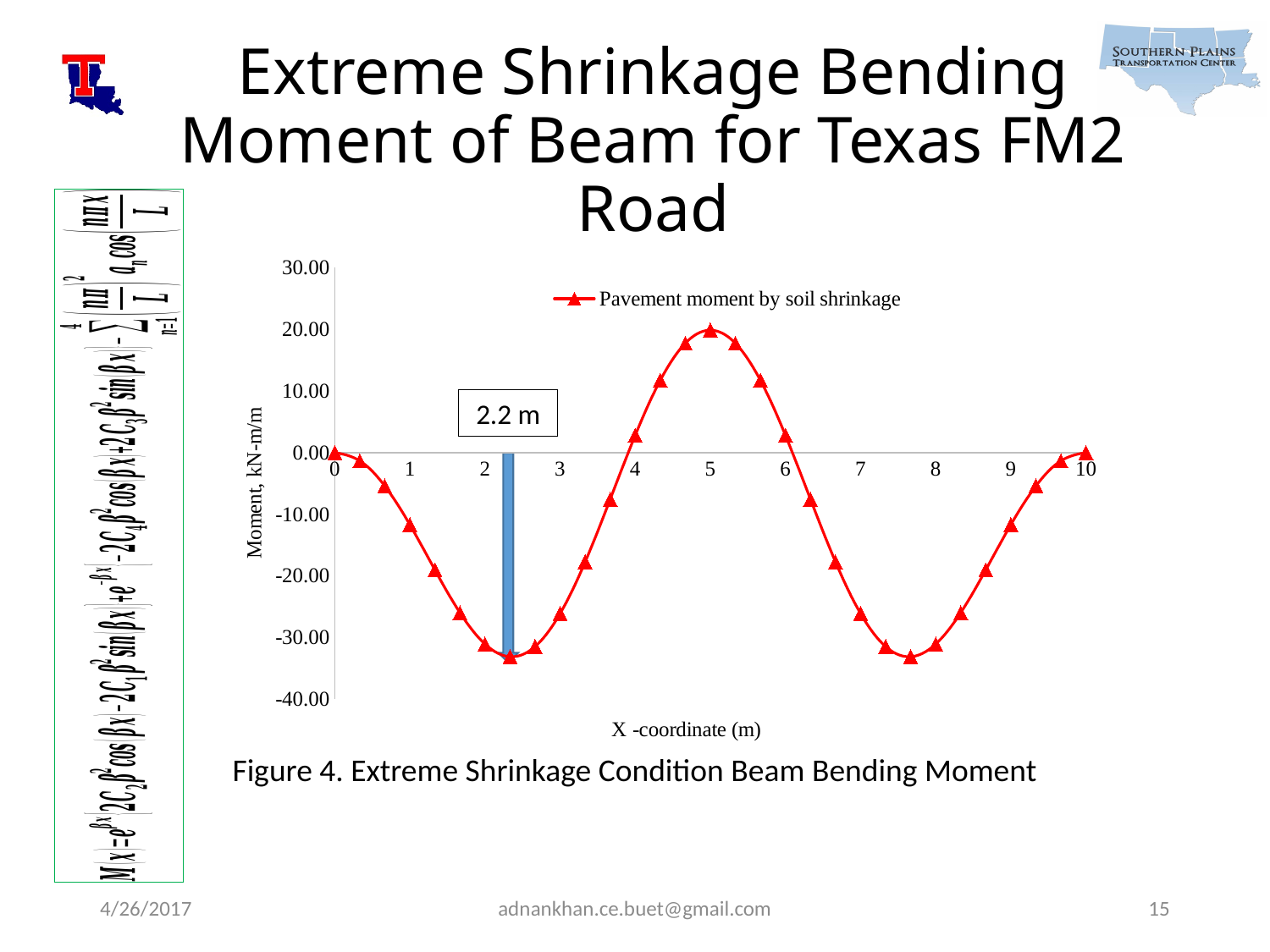
Do the pavement moment values rise or fall as x increases from 2.2 m to 5 m? rise Is the pavement moment at x = 5 m greater or less than 10.00? greater Is the pavement moment at x = 5 m greater or less than 30.00? less What is the name of the series shown in the chart legend? Pavement moment by soil shrinkage What kind of chart is shown on the slide? line chart How many series does the chart legend list? 1 Is the pavement moment at x = 8 m greater or less than -20.00? less Do the pavement moment values rise or fall as x increases from 5 m to 7.5 m? fall At which x-coordinate does the pavement moment reach its highest value? 5 Which is larger, the pavement moment at x = 5 m or at x = 8 m? x = 5 m What x-coordinate is marked by the annotation box on the chart? 2.2 m